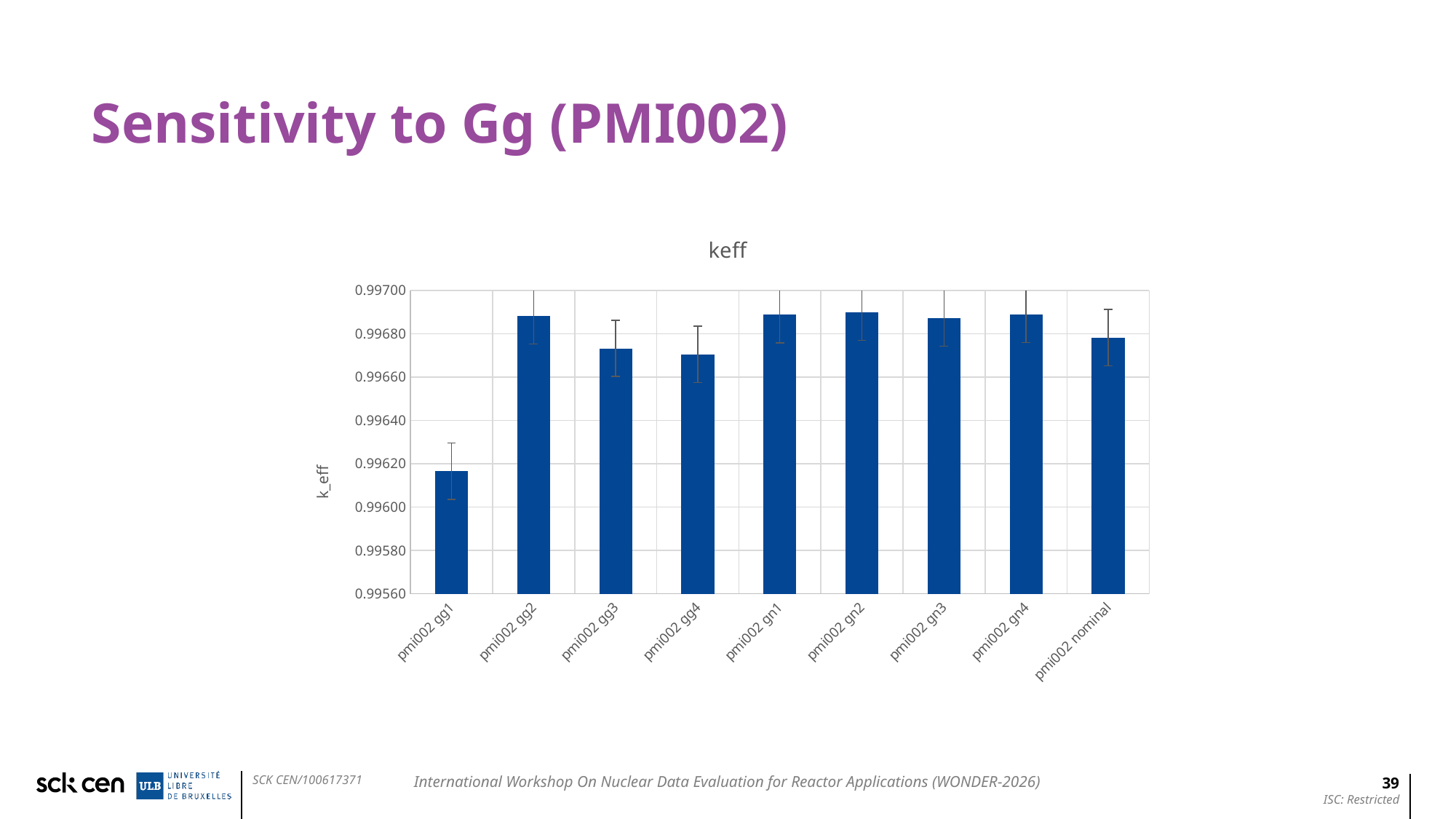
Is the value for pmi002 gg4 greater or less than 0.99660? greater How many categories (bars) are plotted in the chart? 9 Is the value for pmi002 gg3 greater or less than 0.99680? less Which category has the lowest k_eff value? pmi002 gg1 Which is larger, the value for pmi002 gg2 or pmi002 gg1? pmi002 gg2 Is the value for pmi002 gg1 greater or less than 0.99620? less What kind of chart is shown on the slide? bar chart What is the label on the vertical axis of the chart? k_eff Which is larger, the value for pmi002 gn1 or pmi002 gg4? pmi002 gn1 What is the title of the chart? keff